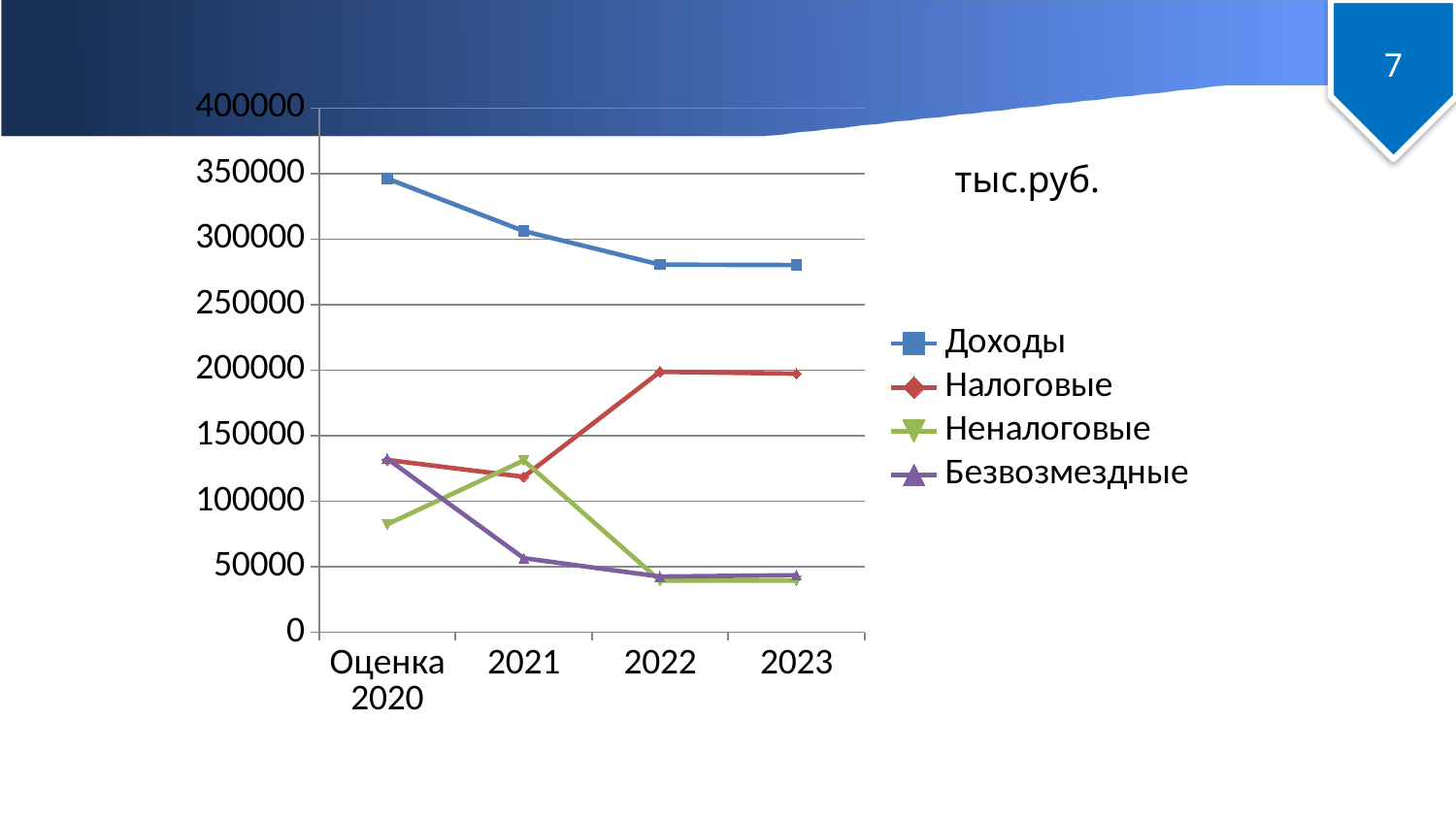
Which series has the highest value in 2022? Доходы What kind of chart is shown on the slide? line chart Does the Доходы series rise or fall from Оценка 2020 to 2023? fall How many series does the legend list? 4 Is the value for Безвозмездные in 2021 greater or less than 50000? greater Is the value for Доходы at Оценка 2020 greater or less than 300000? greater In which year is the Доходы series at its highest? Оценка 2020 Is the value for Неналоговые in 2022 greater or less than 50000? less How many points are plotted along the x axis for each series? 4 Which is larger in 2022, Налоговые or Неналоговые? Налоговые